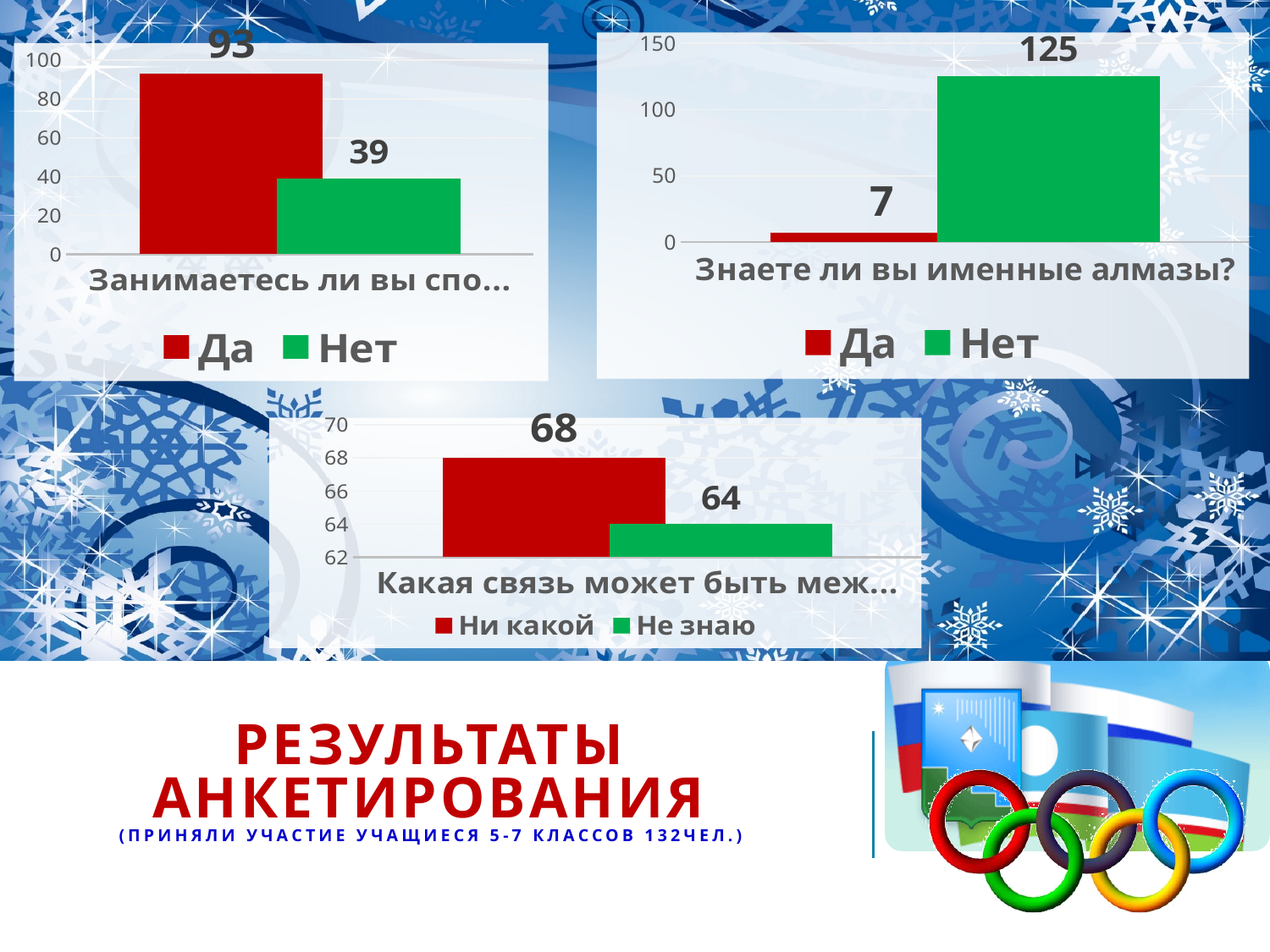
What type of chart is the top-left chart ("Занимаетесь ли вы спо...")? Bar chart In the bottom chart ("Какая связь может быть меж..."), which is larger: "Ни какой" or "Не знаю"? Ни какой In the top-right chart ("Знаете ли вы именные алмазы?"), what is the difference between the "Нет" and "Да" values? 118 In the bottom chart ("Какая связь может быть меж..."), what is the value for "Ни какой"? 68 In the top-right chart ("Знаете ли вы именные алмазы?"), what is the value for "Да"? 7 In the top-right chart ("Знаете ли вы именные алмазы?"), what is the value for "Нет"? 125 In the top-left chart ("Занимаетесь ли вы спо..."), what is the difference between the "Да" and "Нет" values? 54 In the top-left chart ("Занимаетесь ли вы спо..."), what is the value for "Нет"? 39 In the top-left chart ("Занимаетесь ли вы спо..."), what is the value for "Да"? 93 How many series does the legend of the bottom chart ("Какая связь может быть меж...") list? 2 In the top-right chart ("Знаете ли вы именные алмазы?"), which series has the higher value? Нет In the bottom chart ("Какая связь может быть меж..."), what is the value for "Не знаю"? 64